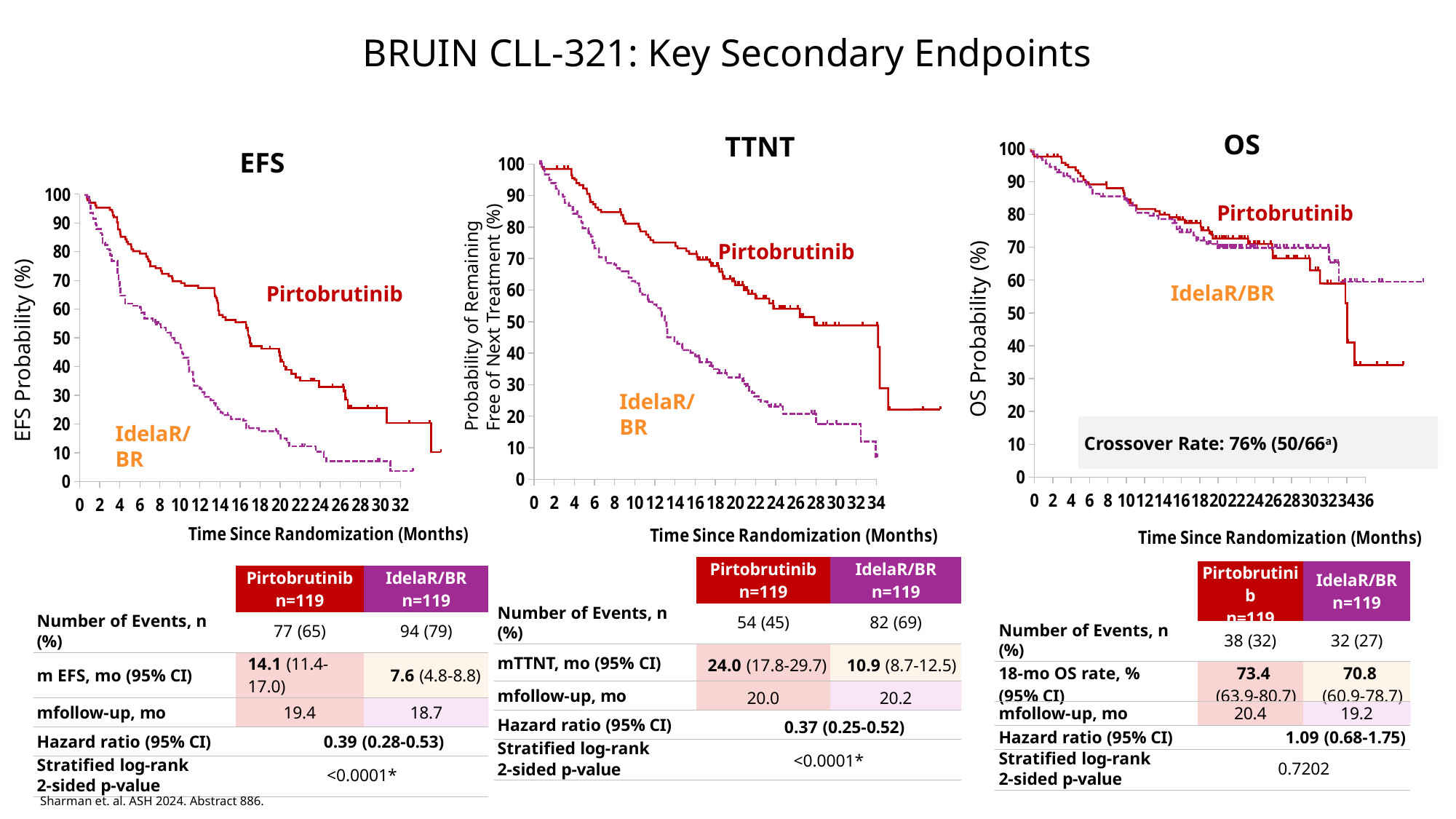
In the table under the EFS chart, what is the median EFS in months for Pirtobrutinib? 14.1 How many series are plotted in the TTNT chart? 2 What is the y-axis label of the OS chart? OS Probability (%) In the OS chart, is the Pirtobrutinib curve at 34 months greater or less than 40? less What crossover rate is printed on the OS chart? 76% (50/66) How many charts are shown on the slide? 3 In the TTNT chart, is the Pirtobrutinib curve at 20 months greater or less than 50? greater What is the x-axis label of the EFS chart? Time Since Randomization (Months) In the EFS chart, which curve is higher at 10 months, Pirtobrutinib or IdelaR/BR? Pirtobrutinib What kind of chart is the EFS chart? line chart In the EFS chart, is the IdelaR/BR curve at 20 months greater or less than 30? less In the TTNT chart, does the Pirtobrutinib curve rise or fall as time since randomization increases? fall